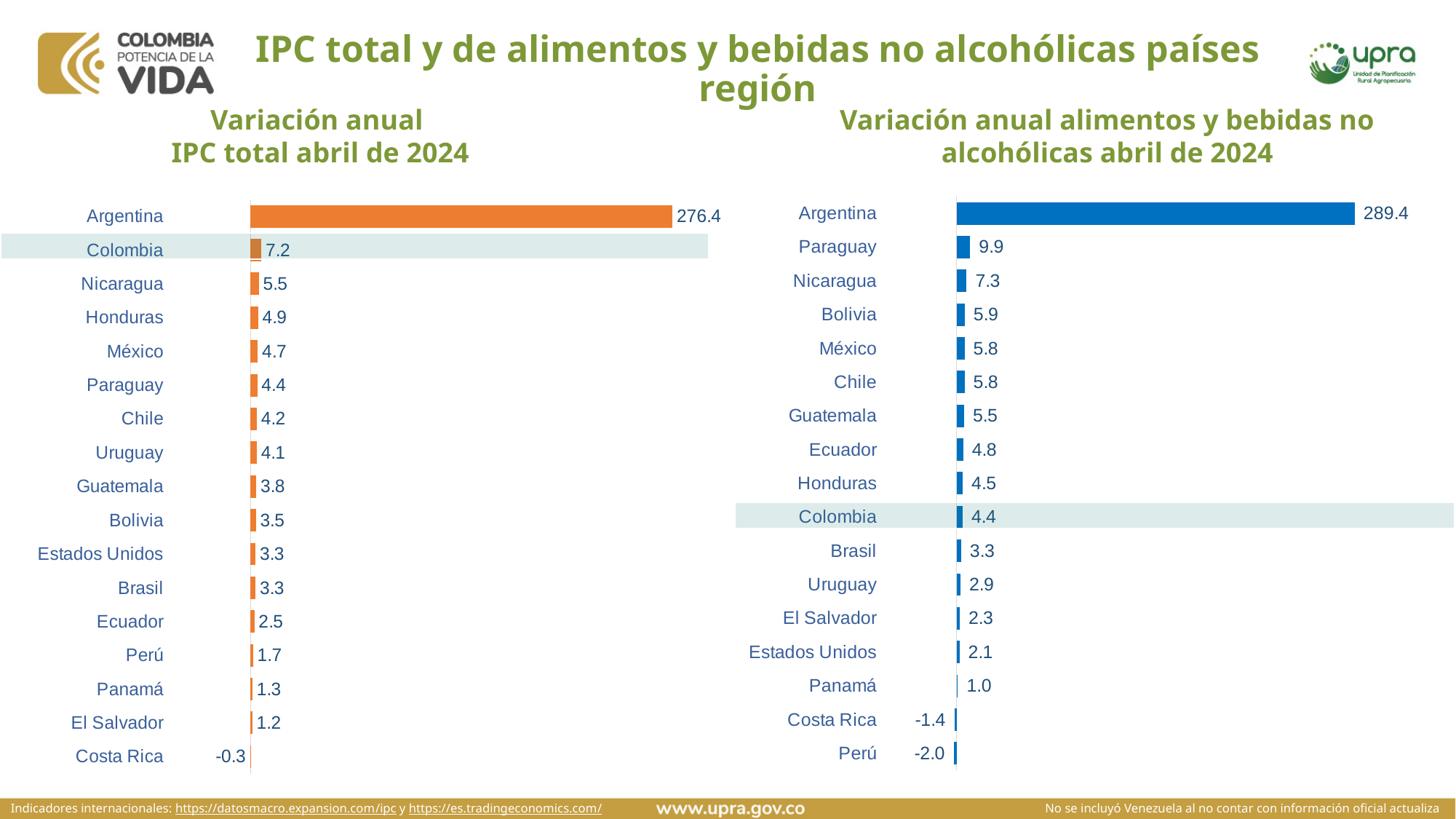
In the 'Variación anual IPC total abril de 2024' chart, how many countries are shown? 17 In the 'Variación anual IPC total abril de 2024' chart, which country has the highest value? Argentina In the 'Variación anual alimentos y bebidas no alcohólicas abril de 2024' chart, which is larger, the value for Nicaragua or the value for Bolivia? Nicaragua In the 'Variación anual alimentos y bebidas no alcohólicas abril de 2024' chart, what is the value for Paraguay? 9.9 In the 'Variación anual alimentos y bebidas no alcohólicas abril de 2024' chart, what is the value for Colombia? 4.4 What kind of chart is the 'Variación anual IPC total abril de 2024' chart? Bar chart In the 'Variación anual alimentos y bebidas no alcohólicas abril de 2024' chart, which country has the lowest value? Perú In the 'Variación anual IPC total abril de 2024' chart, what is the value for Colombia? 7.2 In the 'Variación anual IPC total abril de 2024' chart, which country has the lowest value? Costa Rica In the 'Variación anual IPC total abril de 2024' chart, what is the difference between the values for Argentina and Colombia? 269.2 What colour are the bars in the 'Variación anual alimentos y bebidas no alcohólicas abril de 2024' chart? Blue In the 'Variación anual alimentos y bebidas no alcohólicas abril de 2024' chart, what is the difference between the values for Argentina and Paraguay? 279.5